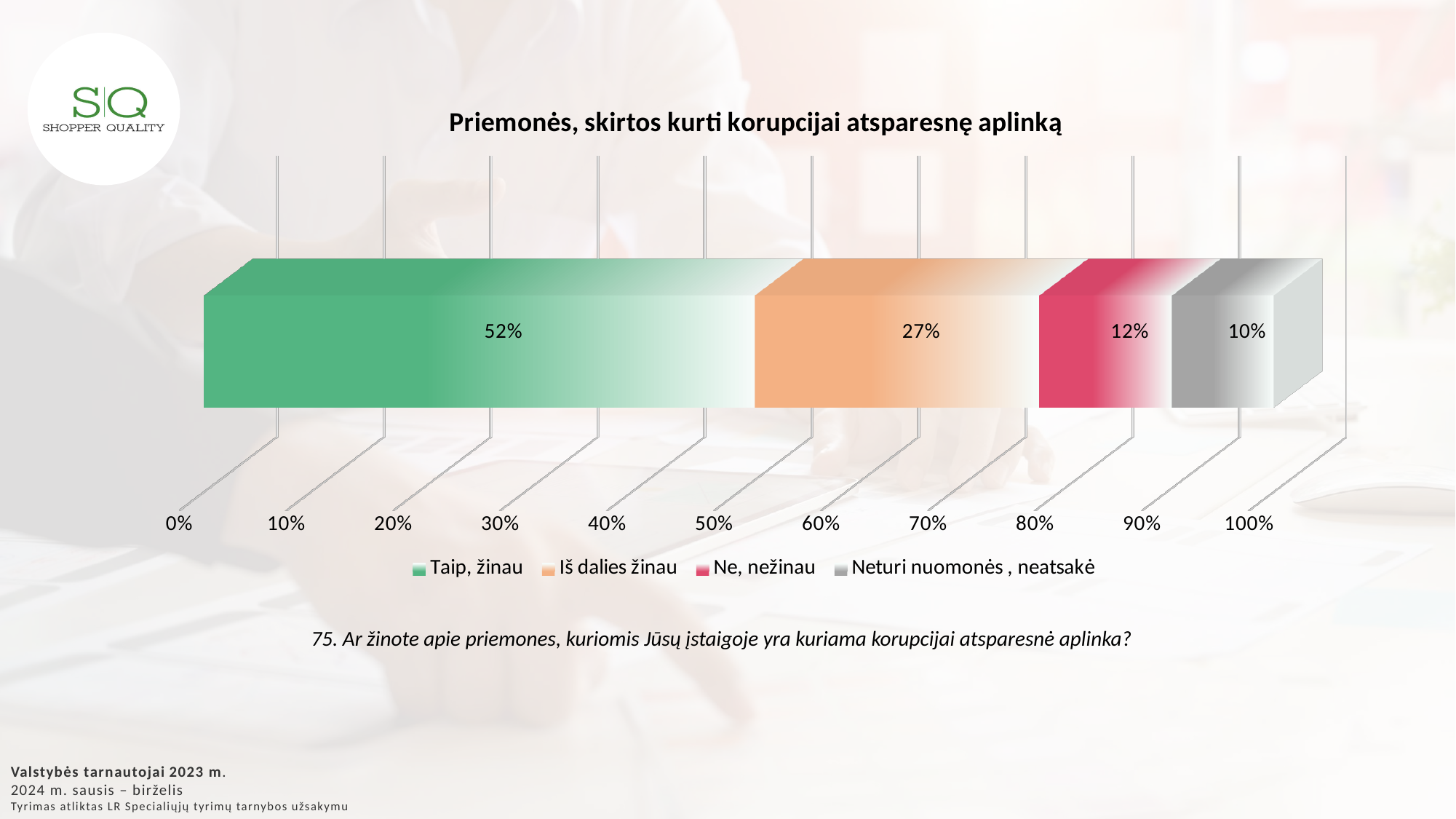
What is the total of the stacked bar? 101% What is the value for "Taip, žinau"? 52% What is the value for "Iš dalies žinau"? 27% How many series does the legend list? 4 What is the title of the chart? Priemonės, skirtos kurti korupcijai atsparesnę aplinką What is the difference between the values for "Taip, žinau" and "Iš dalies žinau"? 25% Which series has the lowest value? Neturi nuomonės , neatsakė What kind of chart is shown on the slide? Stacked bar chart Which series has the highest value? Taip, žinau Which is larger, the value for "Iš dalies žinau" or the value for "Ne, nežinau"? Iš dalies žinau What is the value for "Ne, nežinau"? 12% What is the value for "Neturi nuomonės , neatsakė"? 10%